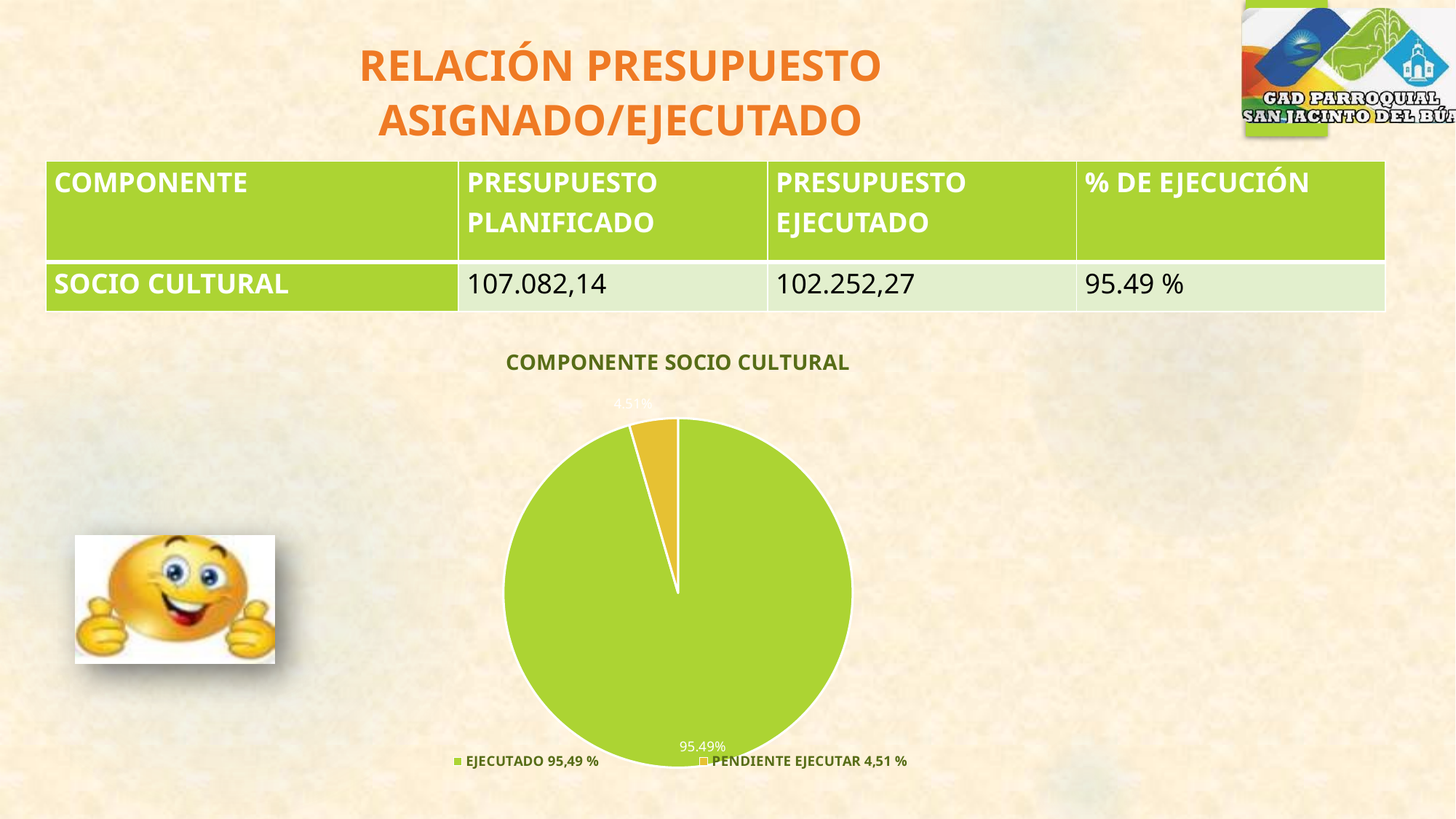
What share of the pie does the PENDIENTE EJECUTAR slice represent? 4.51% How many entries does the chart legend list? 2 What kind of chart is shown on the slide? pie chart Which slice of the pie chart is the smallest? PENDIENTE EJECUTAR Which is larger, the EJECUTADO slice or the PENDIENTE EJECUTAR slice? EJECUTADO What is the title of the chart? COMPONENTE SOCIO CULTURAL Is the share of the PENDIENTE EJECUTAR slice greater or less than 10%? less What share of the pie does the EJECUTADO slice represent? 95.49% How many slices does the pie chart have? 2 What colour is the EJECUTADO slice in the pie chart? green What is the difference in percentage points between the EJECUTADO and PENDIENTE EJECUTAR slices? 90.98 Which slice of the pie chart is the largest? EJECUTADO